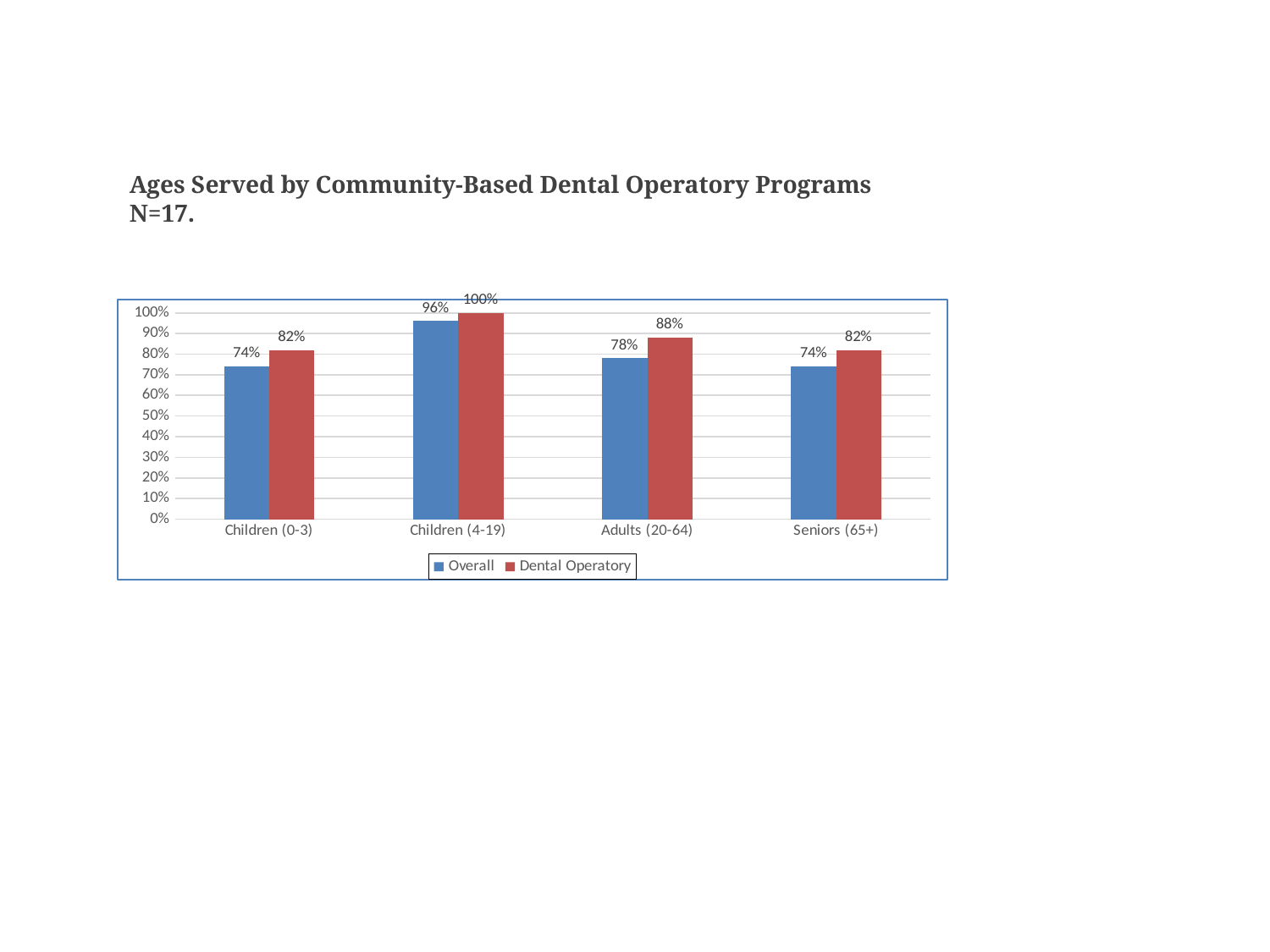
What is the difference between the Dental Operatory and Overall values for Adults (20-64)? 10% What is the Overall value for Seniors (65+)? 74% Which age group has the lowest Dental Operatory value? Children (0-3) and Seniors (65+) What is the Overall value for Children (0-3)? 74% What are the two series named in the legend? Overall and Dental Operatory Which age group has the highest Overall value? Children (4-19) How many age groups are shown on the x axis? 4 What kind of chart is shown on the slide? Bar chart How many series does the legend list? 2 What is the Dental Operatory value for Children (4-19)? 100% Which is larger for Children (4-19): the Overall value or the Dental Operatory value? Dental Operatory What is the Dental Operatory value for Adults (20-64)? 88%